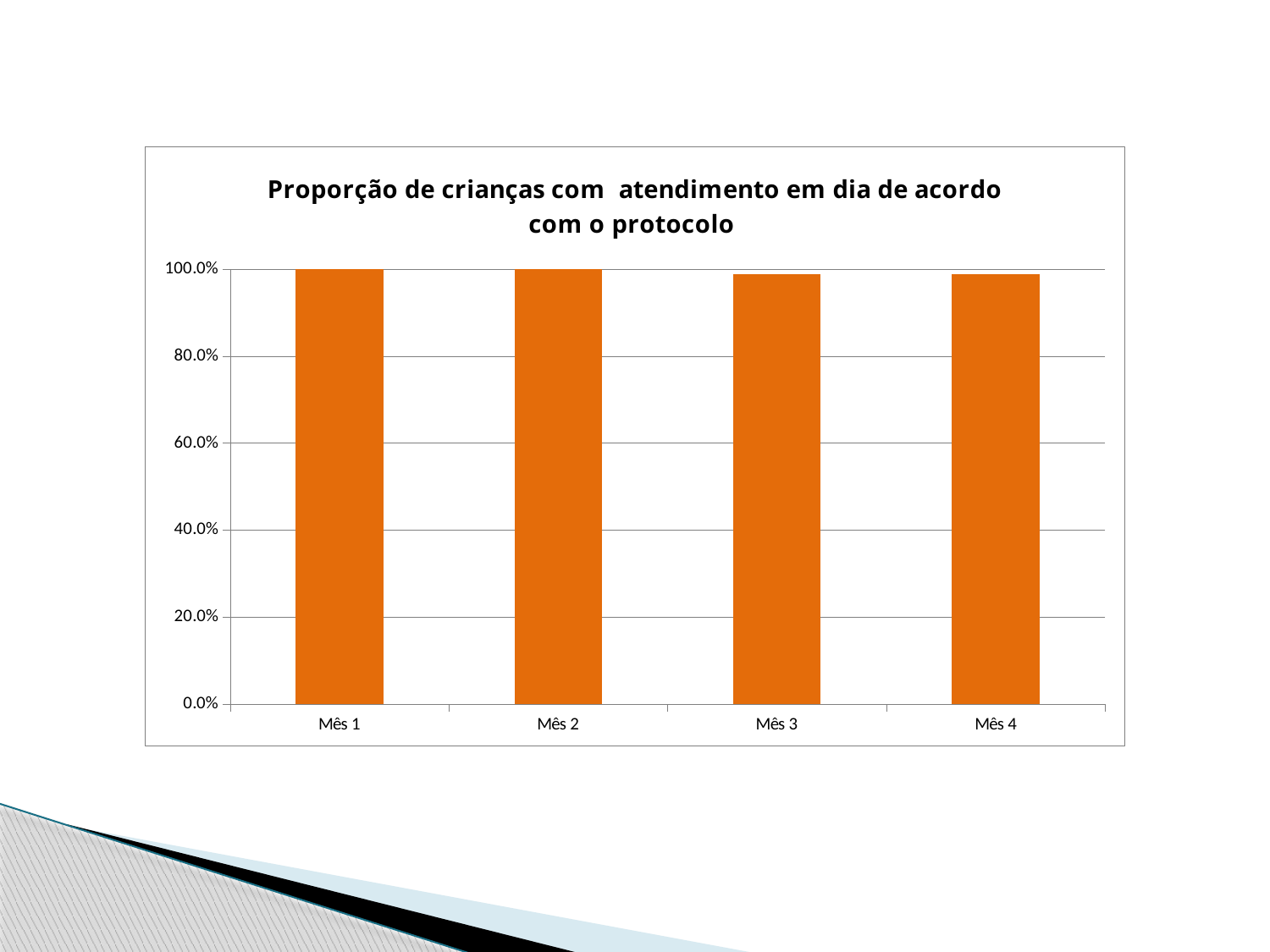
What is the title of the chart? Proporção de crianças com atendimento em dia de acordo com o protocolo Is the value for Mês 3 greater or less than 80.0%? greater How many categories are plotted on the x axis? 4 Is the value for Mês 1 greater or less than 60.0%? greater What colour are the bars in the chart? orange What is the value for Mês 1? 100.0% What is the value for Mês 2? 100.0% Is the value for Mês 2 greater or less than 40.0%? greater What kind of chart is shown on the slide? bar chart